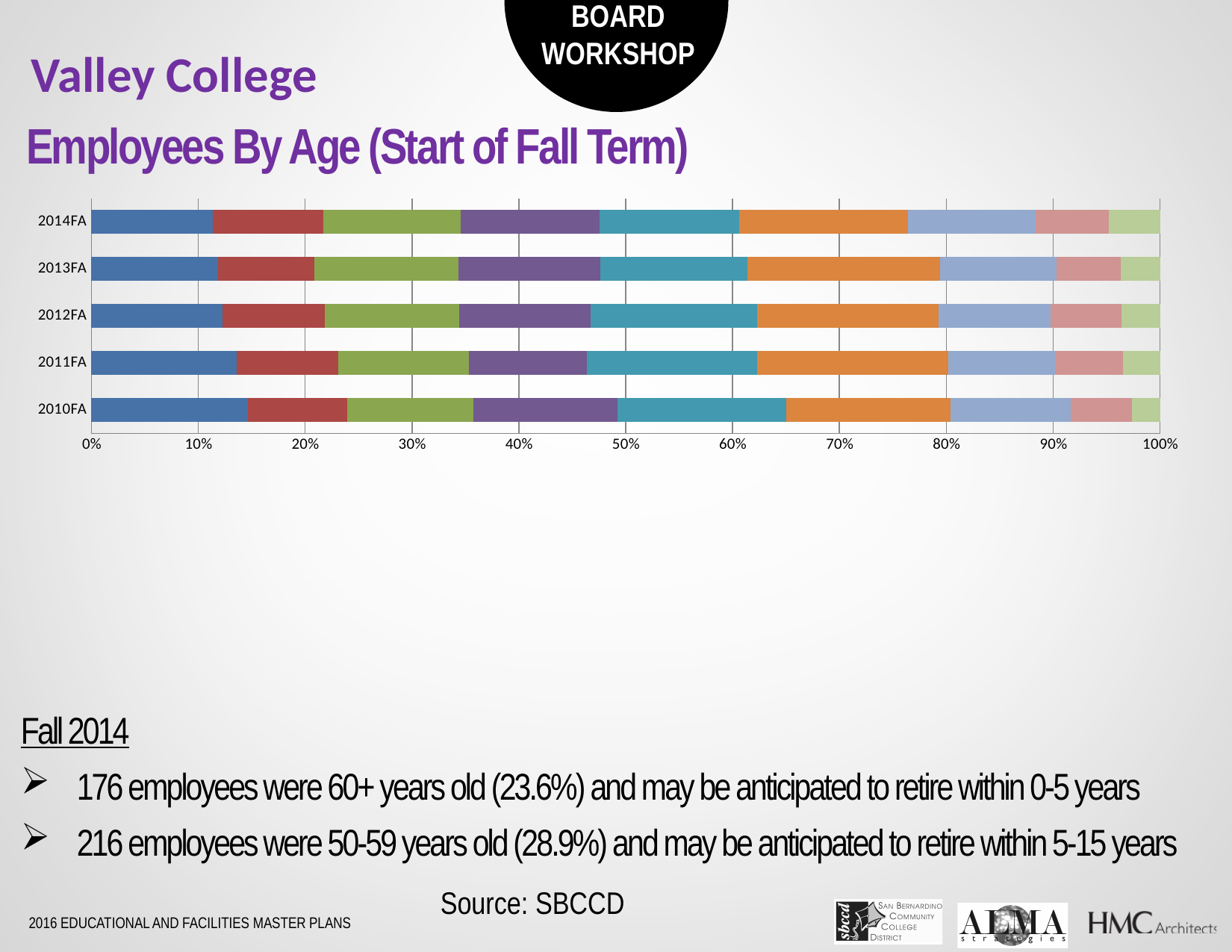
How many fall terms (categories) are plotted on the chart? 5 What kind of chart is shown on the slide? Bar chart Is the leftmost (blue) segment for 2014FA greater or less than 20%? less Does the teal segment for 2014FA end at a point greater or less than 70% on the axis? less What is the title of the chart on the slide? Employees By Age (Start of Fall Term) Is the leftmost (blue) segment for 2010FA greater or less than 10%? greater Which has the larger leftmost (blue) segment, 2010FA or 2014FA? 2010FA Does the chart include a legend identifying the age groups? No How many coloured segments make up each stacked bar? 9 Which fall term is listed at the bottom of the chart? 2010FA